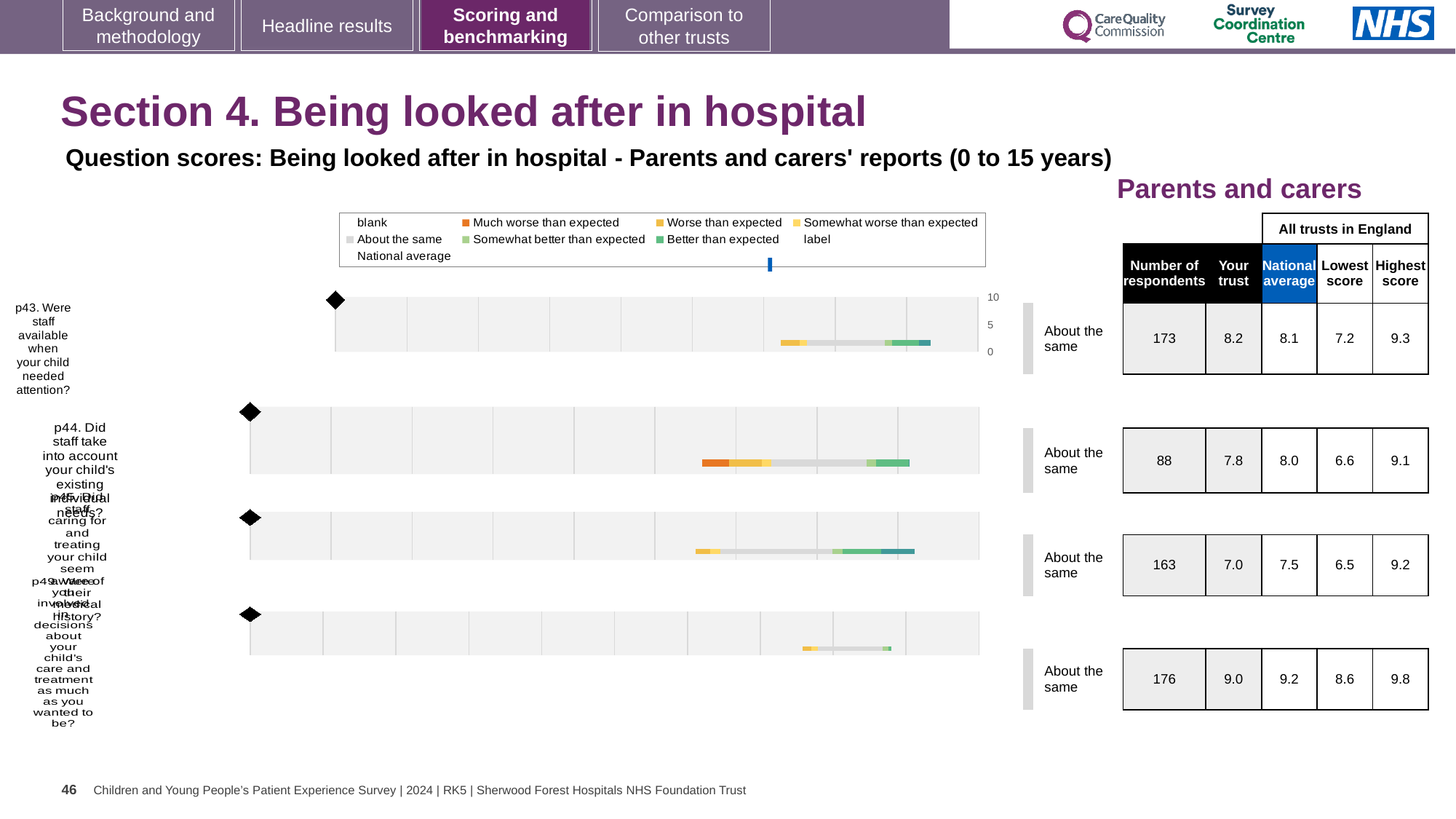
For question p45, is the 'Your trust' score or the national average larger? National average Which question has the highest 'Your trust' score? p49 How many questions (p43, p44, p45, p49) are plotted on the slide? 4 For question p44, what is the national average score? 8.0 For question p49, what is the highest score among all trusts in England? 9.8 What is the difference between the highest score and the lowest score for question p44? 2.5 What benchmark category is shown for question p43? About the same For question p45, how many respondents are listed? 163 Which question has the lowest 'Your trust' score? p45 What kind of chart is used to show the question scores on this slide? bar chart For question p43, what is the 'Your trust' score shown in the table? 8.2 In the legend, what colour represents 'Much worse than expected'? Orange